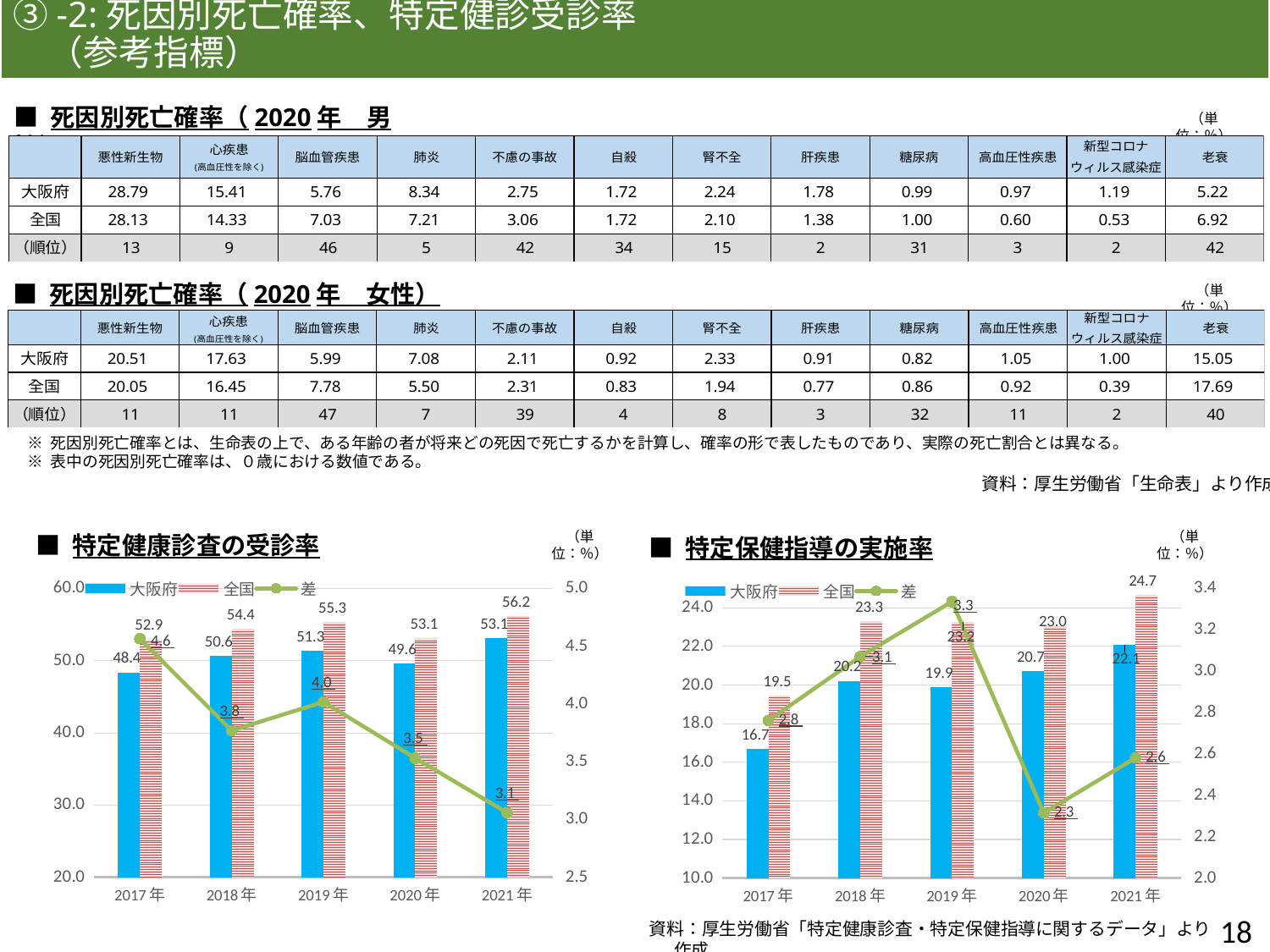
In the 特定保健指導の実施率 chart, does the 差 line rise or fall from 2019年 to 2020年? fall In the 特定健康診査の受診率 chart, how many series does the legend list? 3 In the 特定保健指導の実施率 chart, what is the value for 全国 in 2021年? 24.7 In the 特定健康診査の受診率 chart, what is the 差 value in 2017年? 4.6 In the 特定健康診査の受診率 chart, what is the value for 大阪府 in 2021年? 53.1 In the 特定健康診査の受診率 chart, which year has the lowest 大阪府 value? 2017年 In the 特定保健指導の実施率 chart, what is the value for 大阪府 in 2017年? 16.7 In the 特定健康診査の受診率 chart, what is the value for 全国 in 2019年? 55.3 In the 特定保健指導の実施率 chart, which year has the highest 差 value? 2019年 In the 特定保健指導の実施率 chart, which is larger, the 大阪府 value in 2020年 or in 2021年? 2021年 In the 特定健康診査の受診率 chart, what is the difference between the 全国 and 大阪府 values in 2018年? 3.8 In the 特定保健指導の実施率 chart, how many years are shown on the x axis? 5